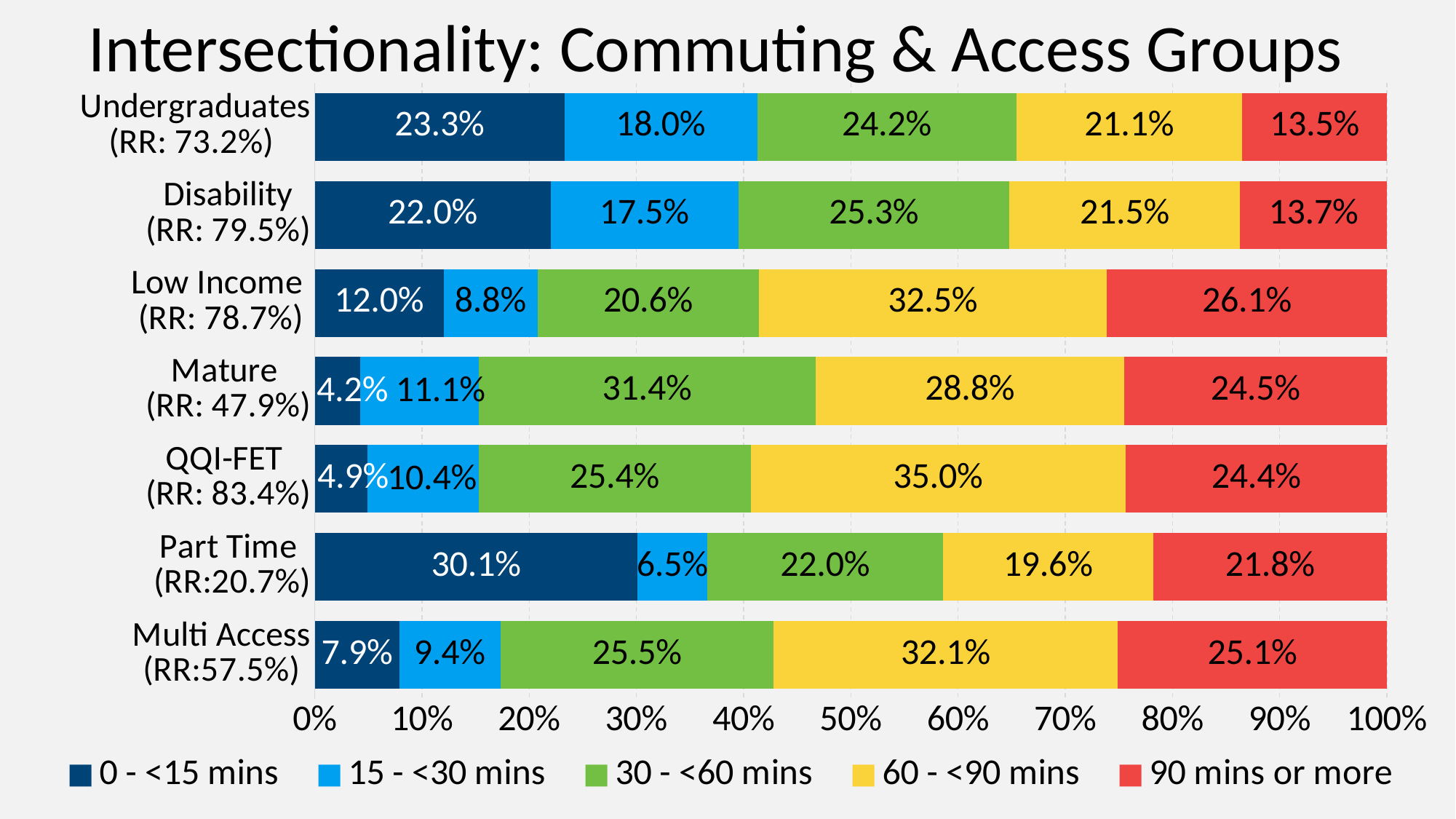
What is the title of the chart? Intersectionality: Commuting & Access Groups What percentage of Mature students commute 30 - <60 mins? 31.4% Which group has the lowest share in the 0 - <15 mins category? Mature How many groups are shown on the chart? 7 Which group has the highest share in the 0 - <15 mins category? Part Time What is the difference between the 0 - <15 mins values for Undergraduates and Disability? 1.3 percentage points What is the value for Part Time in the 0 - <15 mins series? 30.1% What percentage of Low Income students commute 60 - <90 mins? 32.5% How many series does the legend list? 5 What kind of chart is shown on the slide? Stacked bar chart Which is larger: the 60 - <90 mins value for QQI-FET or for Low Income? QQI-FET Which group has the highest share in the 90 mins or more category? Low Income